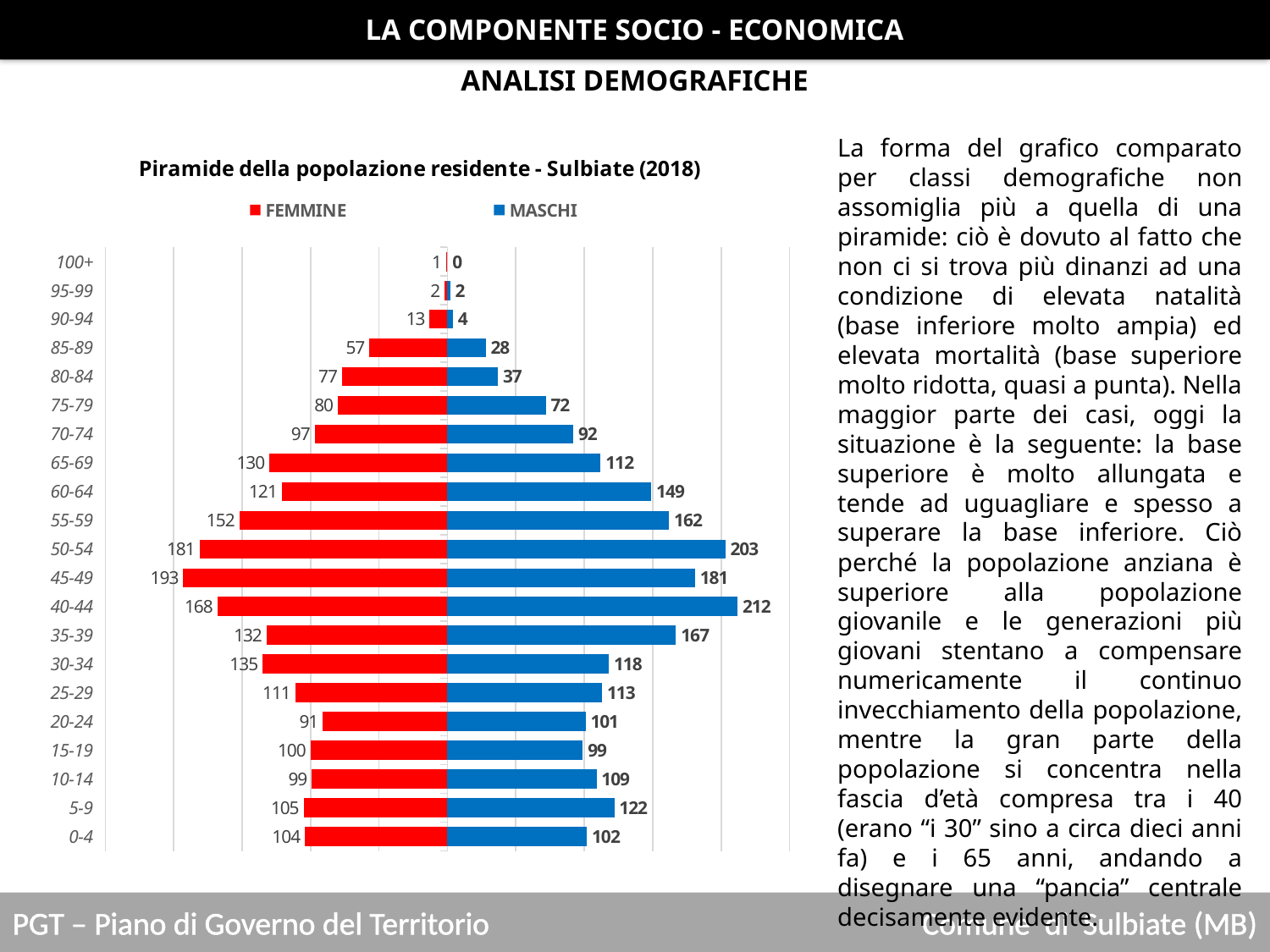
For the 65-69 age group, which is larger, the FEMMINE value or the MASCHI value? FEMMINE How many series does the chart legend list? 2 Which age group has the highest FEMMINE value? 45-49 What is the MASCHI value for the 40-44 age group? 212 How many age categories are shown on the chart? 21 What is the total of the FEMMINE and MASCHI values for the 0-4 age group? 206 What is the title of the chart? Piramide della popolazione residente - Sulbiate (2018) What is the difference between the MASCHI and FEMMINE values for the 50-54 age group? 22 What kind of chart is shown on the slide? bar chart Which age group has the lowest MASCHI value? 100+ Which age group has the highest MASCHI value? 40-44 What is the FEMMINE value for the 45-49 age group? 193